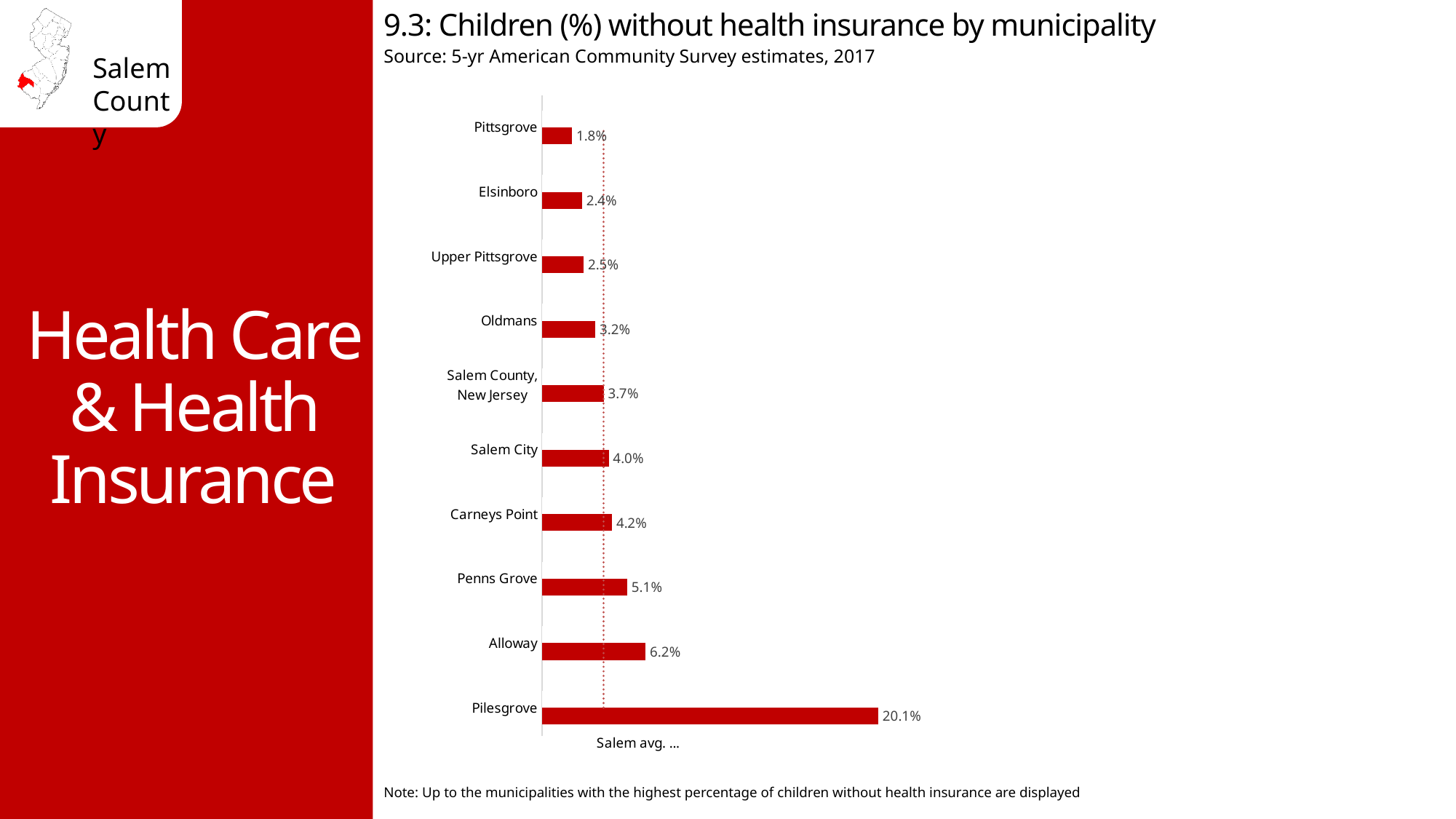
Which municipality has the lowest percentage of children without health insurance? Pittsgrove How many categories are plotted on the chart? 10 What is the difference between the values for Alloway and Penns Grove? 1.1% Which has a higher value, Carneys Point or Oldmans? Carneys Point Which has a lower value, Elsinboro or Upper Pittsgrove? Elsinboro What kind of chart is shown on the slide? Bar chart What percentage of children in Pilesgrove are without health insurance? 20.1% What is the source cited for the chart? 5-yr American Community Survey estimates, 2017 What is the value shown for Salem County, New Jersey? 3.7% Which municipality has the highest percentage of children without health insurance? Pilesgrove What is the value shown for Salem City? 4.0% What is the difference between the values for Pilesgrove and Pittsgrove? 18.3%